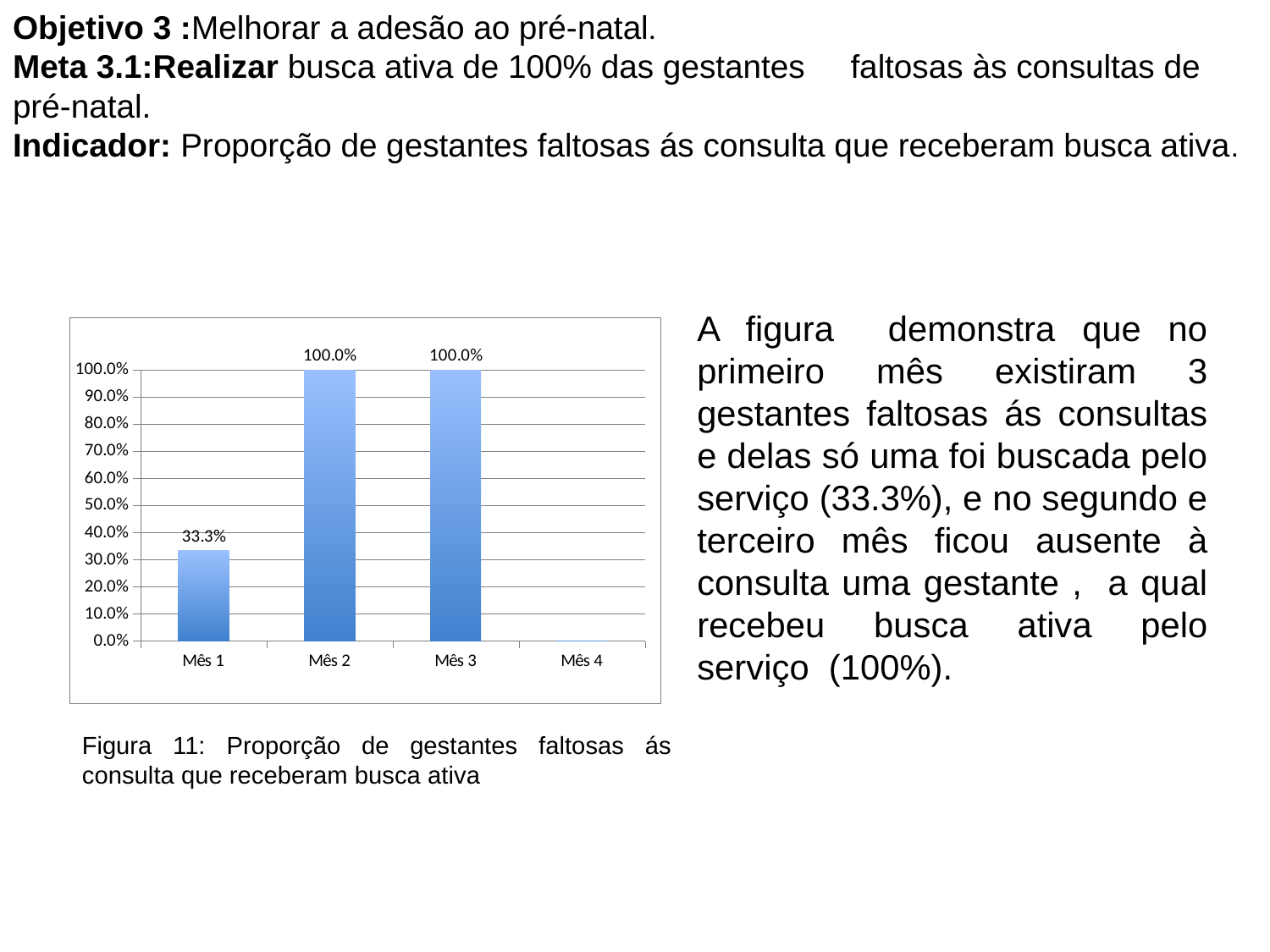
Is the value for Mês 1 greater or less than 50.0%? less Which is larger, the value for Mês 1 or the value for Mês 3? Mês 3 What is the difference between the values for Mês 2 and Mês 1? 66.7% Which month has the lowest value among the months with a bar? Mês 1 What is the value for Mês 3? 100.0% Which category on the x axis has no bar plotted? Mês 4 Do the values rise or fall from Mês 1 to Mês 2? rise How many categories are shown on the x axis? 4 What is the value for Mês 2? 100.0% What is the value for Mês 1? 33.3% What is the highest value shown on the y axis? 100.0% What kind of chart is shown on the slide? bar chart